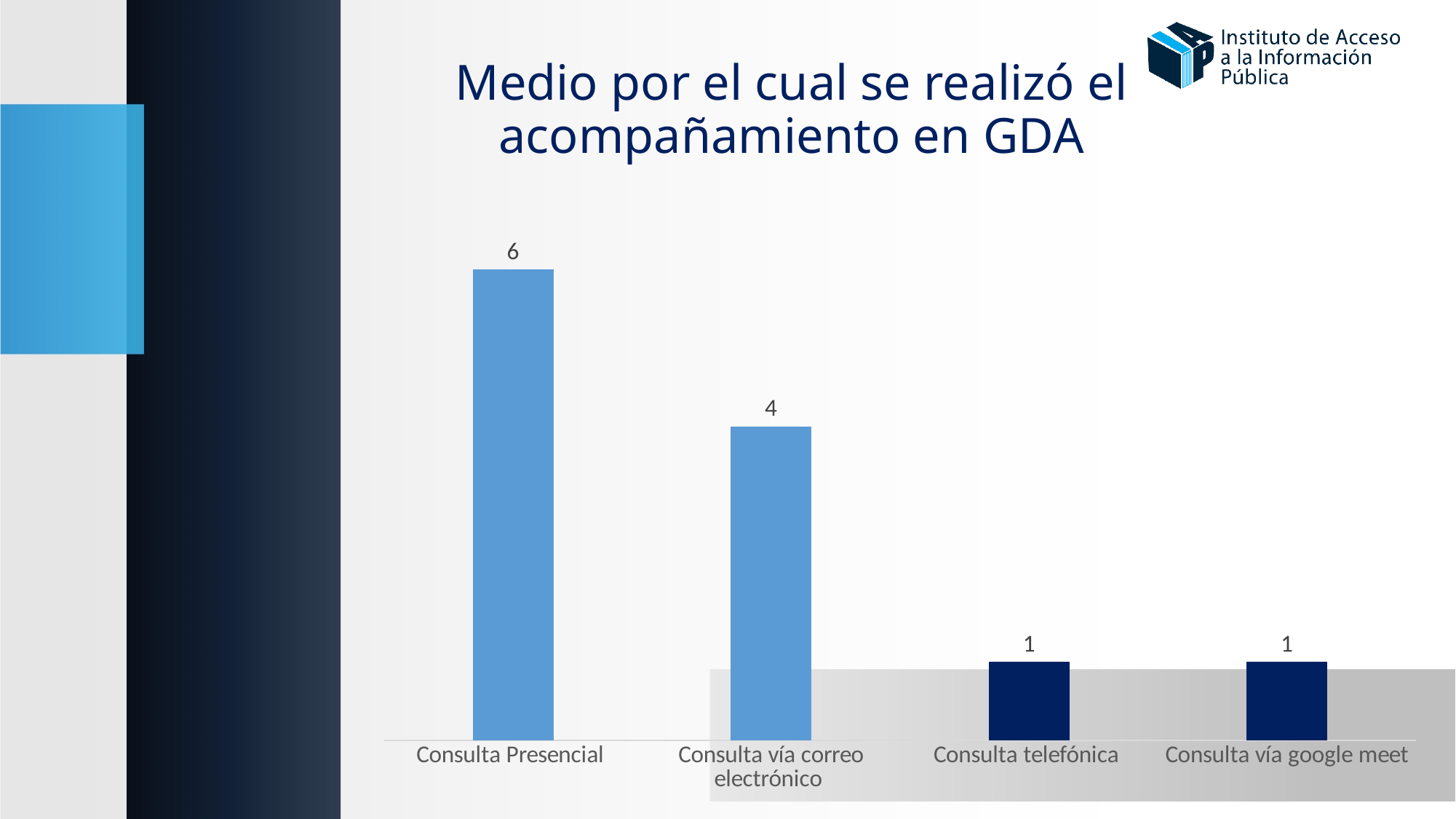
What is the value for Consulta vía correo electrónico? 4 Which category has the highest value? Consulta Presencial What is the difference between Consulta vía correo electrónico and Consulta telefónica? 3 Do the values rise or fall from left to right across the categories? Fall What is the difference between Consulta Presencial and Consulta vía correo electrónico? 2 What is the value for Consulta Presencial? 6 How many categories are shown in the chart? 4 What is the value for Consulta vía google meet? 1 What is the title of the chart on the slide? Medio por el cual se realizó el acompañamiento en GDA Which is larger, Consulta Presencial or Consulta vía correo electrónico? Consulta Presencial What kind of chart is shown on the slide? Bar chart What is the value for Consulta telefónica? 1